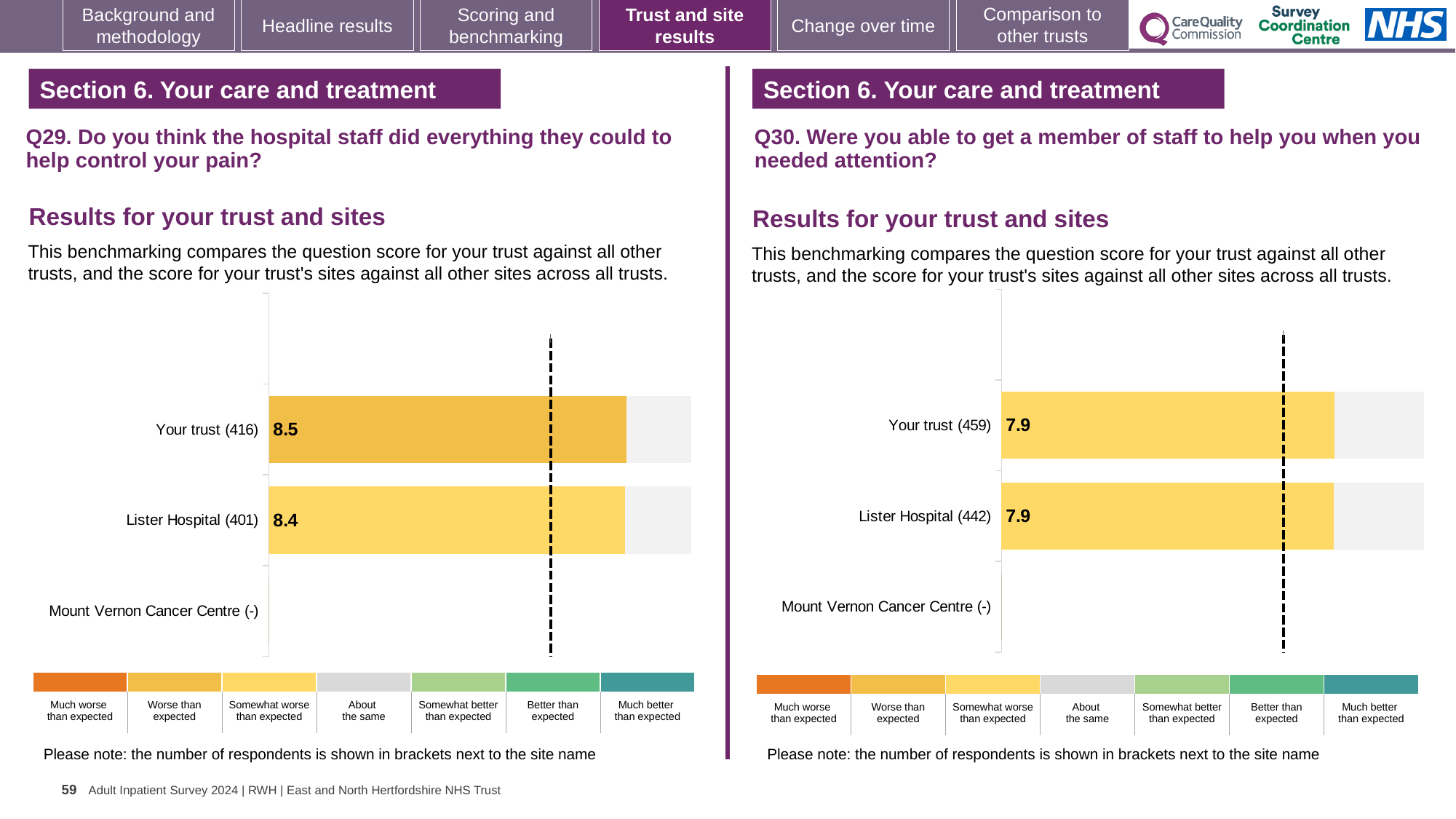
In the Q29 chart on the left, what is the score for Lister Hospital? 8.4 In the Q30 chart on the right, how many respondents are shown in brackets for Your trust? 459 In the Q30 chart on the right, how many respondents are shown in brackets for Lister Hospital? 442 In the Q29 chart on the left, what is the score for Your trust? 8.5 In the Q30 chart on the right, what is the score for Lister Hospital? 7.9 In the Q29 chart on the left, what is the difference between the Your trust score and the Lister Hospital score? 0.1 In the Q29 chart on the left, how many site or trust categories are listed on the vertical axis? 3 In the Q29 chart on the left, how many respondents are shown in brackets for Your trust? 416 In the Q30 chart on the right, what is the score for Your trust? 7.9 In the Q29 chart on the left, which benchmarking category does the colour of the Your trust bar correspond to in the legend? Worse than expected In the Q30 chart on the right, which category has no score shown? Mount Vernon Cancer Centre What kind of chart is used in the Q30 chart on the right? Bar chart